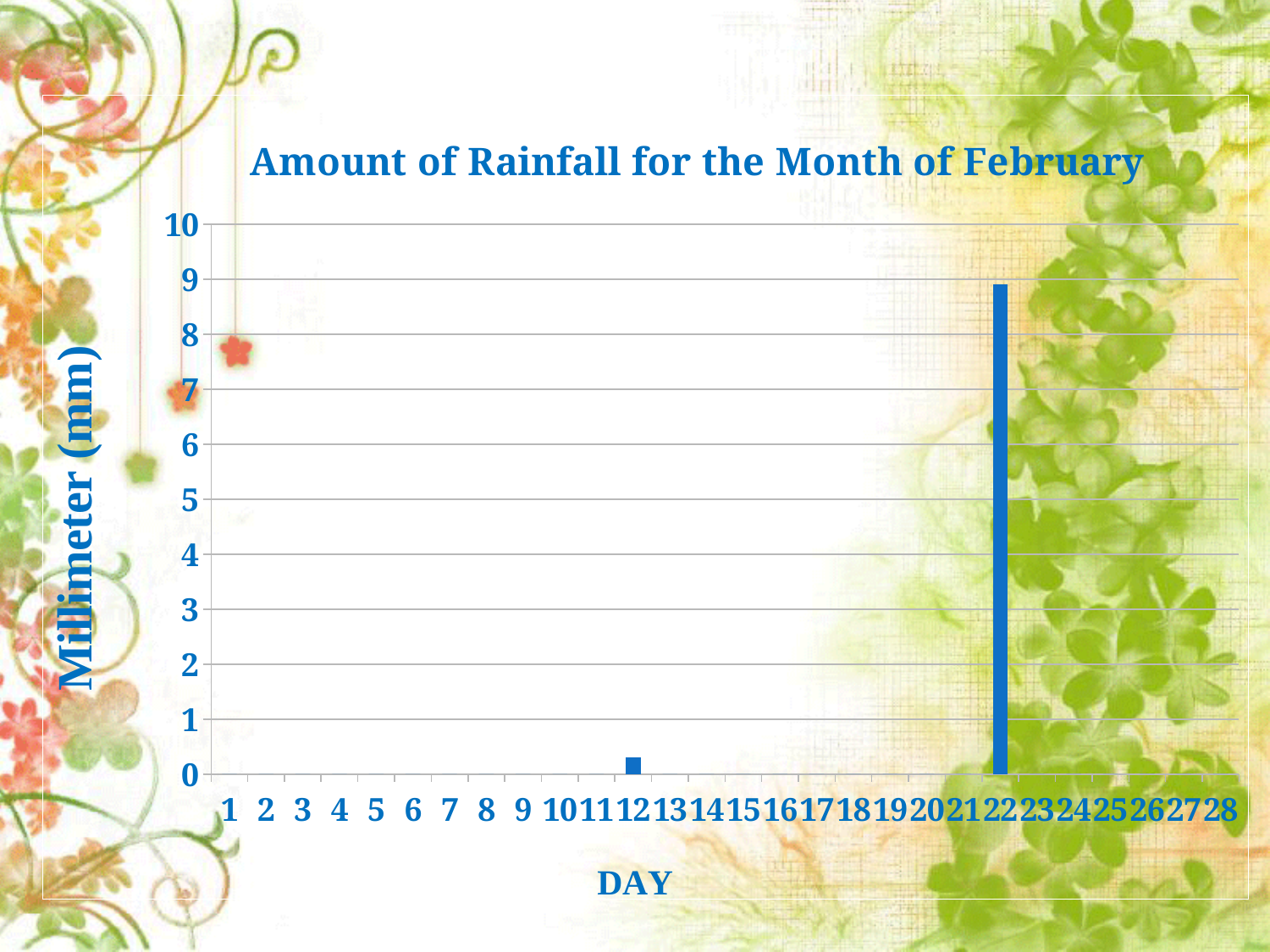
Is the rainfall value for day 22 greater or less than 5? greater How many days show a visible rainfall bar? 2 What kind of chart is shown on the slide? bar chart Which day has the highest amount of rainfall? 22 Is the rainfall value for day 22 greater or less than 8? greater What is the label of the vertical axis? Millimeter (mm) Is the rainfall value for day 12 greater or less than 1? less What is the title of the chart? Amount of Rainfall for the Month of February What is the highest value shown on the vertical axis? 10 How many days are shown along the x axis? 28 Which day has more rainfall, day 12 or day 22? 22